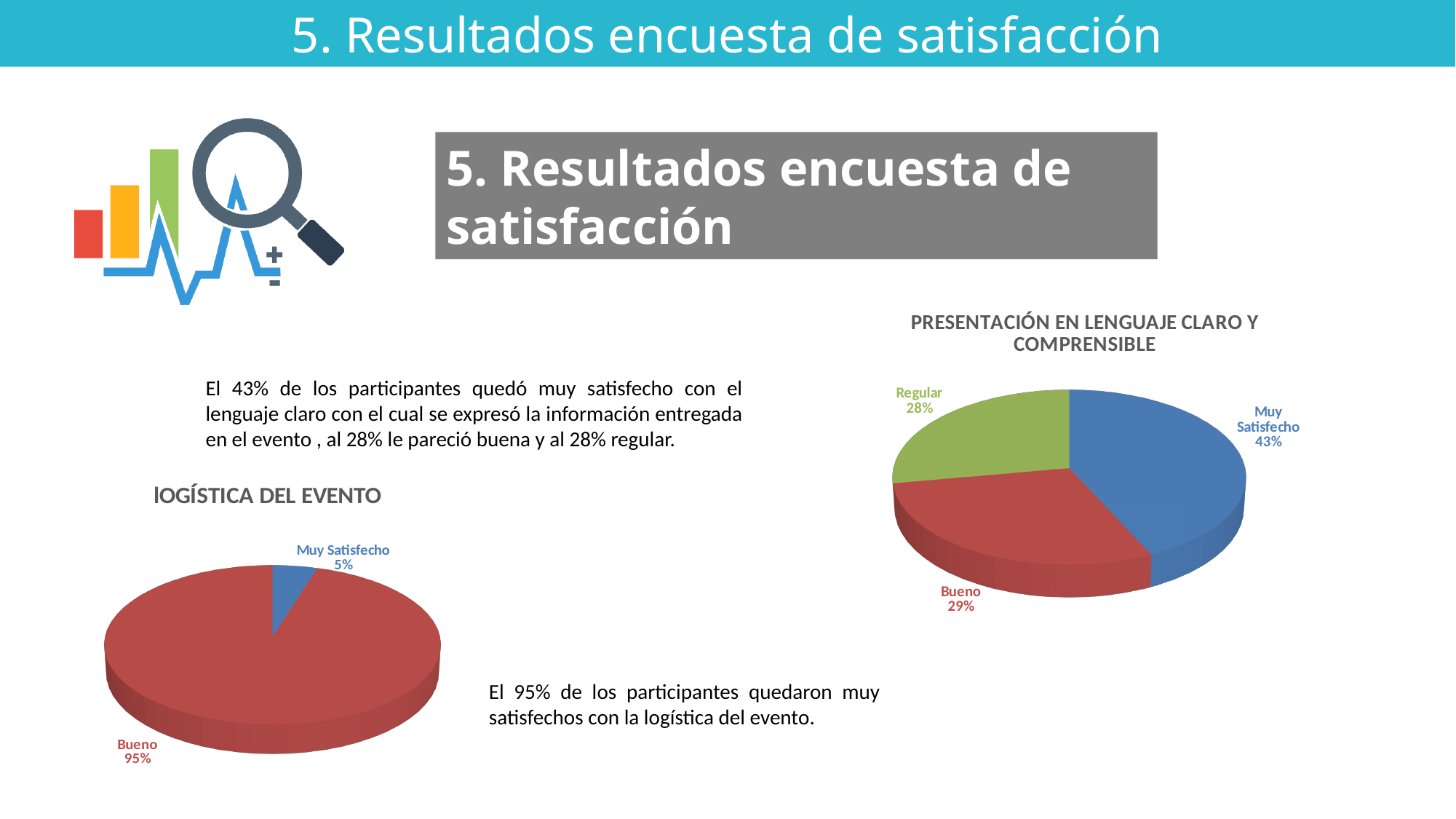
In the 'PRESENTACIÓN EN LENGUAJE CLARO Y COMPRENSIBLE' chart, how many categories are shown? 3 What type of chart is 'lOGÍSTICA DEL EVENTO'? Pie chart In the 'lOGÍSTICA DEL EVENTO' chart, which category has the largest slice? Bueno In the 'PRESENTACIÓN EN LENGUAJE CLARO Y COMPRENSIBLE' chart, which is larger, Muy Satisfecho or Bueno? Muy Satisfecho In the 'PRESENTACIÓN EN LENGUAJE CLARO Y COMPRENSIBLE' chart, what is the share for Bueno? 29% In the 'lOGÍSTICA DEL EVENTO' chart, what is the difference between the Bueno and Muy Satisfecho shares? 90% In the 'PRESENTACIÓN EN LENGUAJE CLARO Y COMPRENSIBLE' chart, what is the share for Regular? 28% In the 'lOGÍSTICA DEL EVENTO' chart, what share of participants rated the logistics as Bueno? 95% In the 'PRESENTACIÓN EN LENGUAJE CLARO Y COMPRENSIBLE' chart, which category has the smallest slice? Regular In the 'lOGÍSTICA DEL EVENTO' chart, what percentage corresponds to Muy Satisfecho? 5% In the 'PRESENTACIÓN EN LENGUAJE CLARO Y COMPRENSIBLE' chart, what percentage of participants were Muy Satisfecho? 43% In the 'lOGÍSTICA DEL EVENTO' chart, how many slices does the pie have? 2